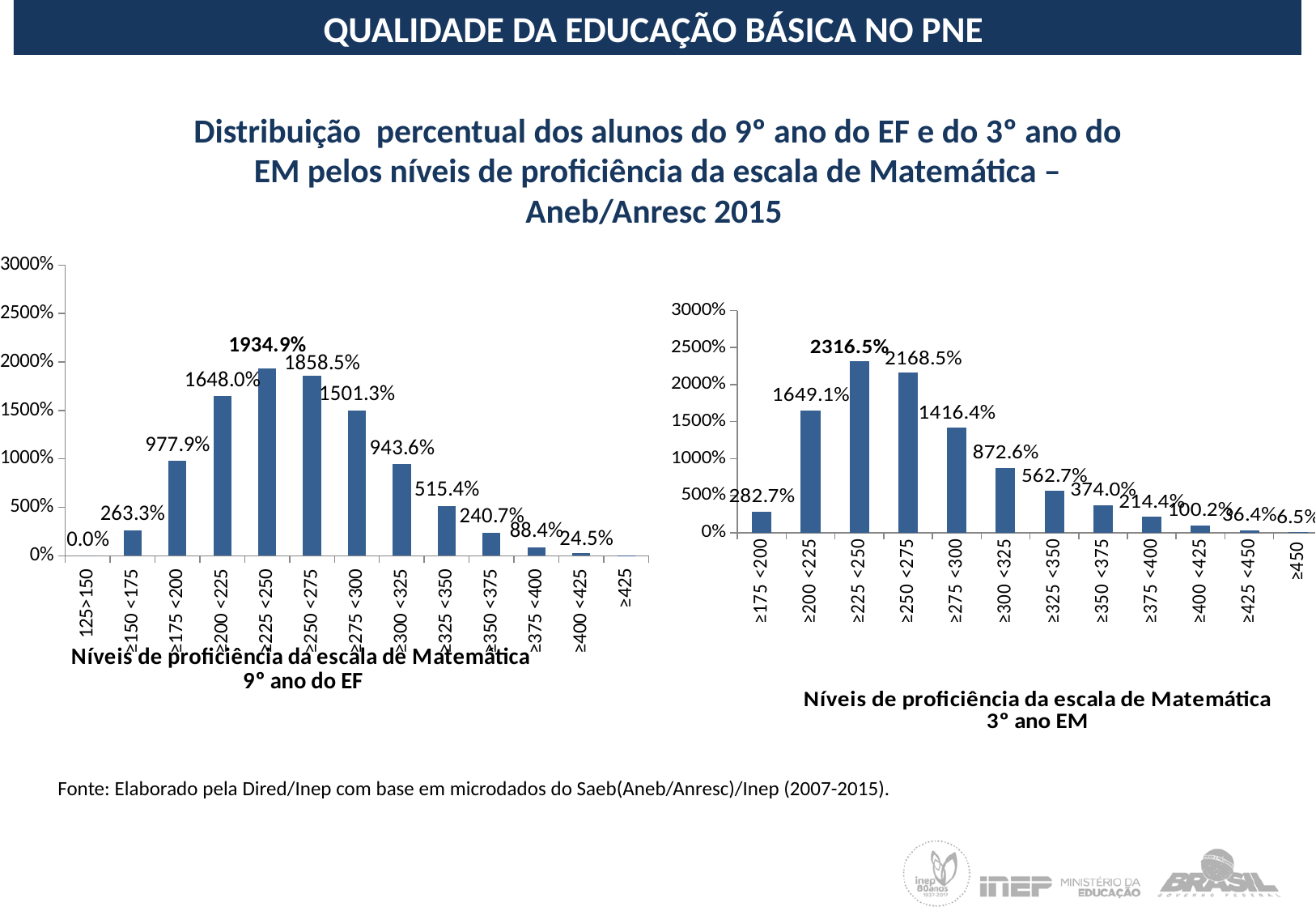
What kind of chart is the left chart (9° ano do EF)? bar chart How many proficiency levels are shown on the x axis of the right chart (3° ano EM)? 12 In the left chart (9° ano do EF), which proficiency level has the lowest value? 125>150 In the left chart (9° ano do EF), what is the value for the ≥225 <250 level? 1934.9% In the right chart (3° ano EM), what is the value for the ≥450 level? 6.5% In the left chart (9° ano do EF), what is the difference between the values for ≥225 <250 and ≥250 <275? 76.4% In the right chart (3° ano EM), which is larger: the value for ≥200 <225 or the value for ≥275 <300? ≥200 <225 What is the x-axis title of the right chart? Níveis de proficiência da escala de Matemática 3° ano EM In the right chart (3° ano EM), which proficiency level has the highest value? ≥225 <250 In the right chart (3° ano EM), what is the value for the ≥250 <275 level? 2168.5% In the right chart (3° ano EM), do the values rise or fall from ≥225 <250 to ≥450? fall In the left chart (9° ano do EF), is the value for ≥300 <325 greater or less than 1000%? less